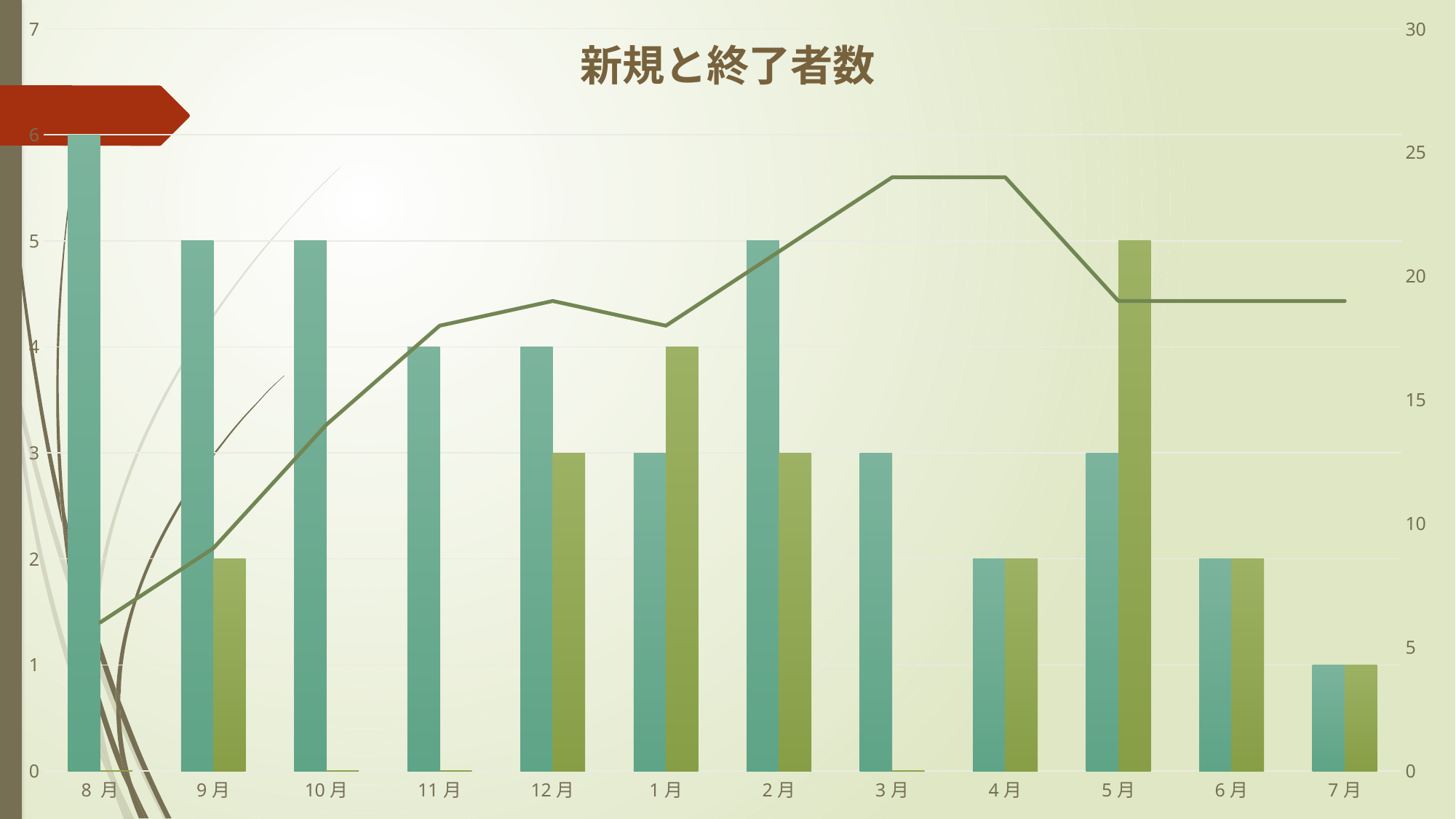
What is the value of the olive bar for 5月? 5 What type of chart is shown on the slide? A bar chart combined with a line chart What is the difference between the teal bar and the olive bar for 1月? 1 What is the value of the teal bar for 7月? 1 Does the line rise or fall from 8月 to 3月? Rises Which month has the highest olive bar? 5月 Which month has the highest teal bar? 8月 How many months are shown on the x axis of the chart? 12 What is the value of the teal bar for 8月? 6 What is the title of the chart? 新規と終了者数 Which is larger for 2月, the teal bar or the olive bar? The teal bar Is the value of the line for 3月 on the right axis greater or less than 20? greater